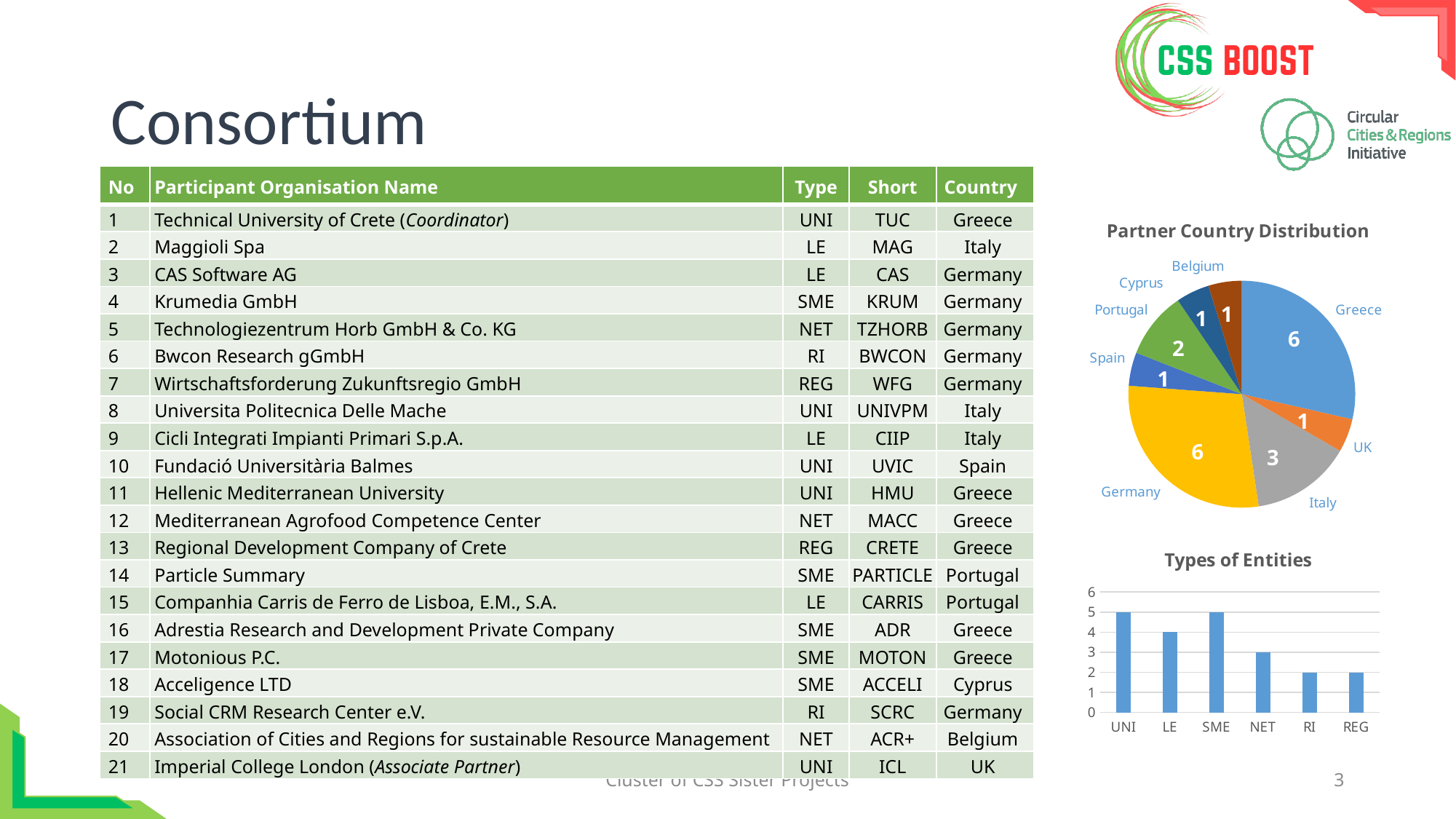
In the Types of Entities chart, which entity type has the lowest value? RI and REG In the Partner Country Distribution pie chart, what is the difference between the number of partners from Greece and from Italy? 3 In the Partner Country Distribution pie chart, which is larger, the Italy slice or the Portugal slice? Italy What kind of chart is the Types of Entities chart? Bar chart In the Types of Entities chart, what is the value for NET? 3 In the Partner Country Distribution pie chart, how many partners are from Portugal? 2 In the Types of Entities chart, what is the value for LE? 4 In the Partner Country Distribution pie chart, how many partners are from Italy? 3 In the Partner Country Distribution pie chart, how many countries are shown as slices? 8 In the Partner Country Distribution pie chart, what is the total number of partners across all countries? 21 In the Types of Entities chart, what is the difference between the values for UNI and RI? 3 In the Types of Entities chart, how many entity types are shown on the x axis? 6